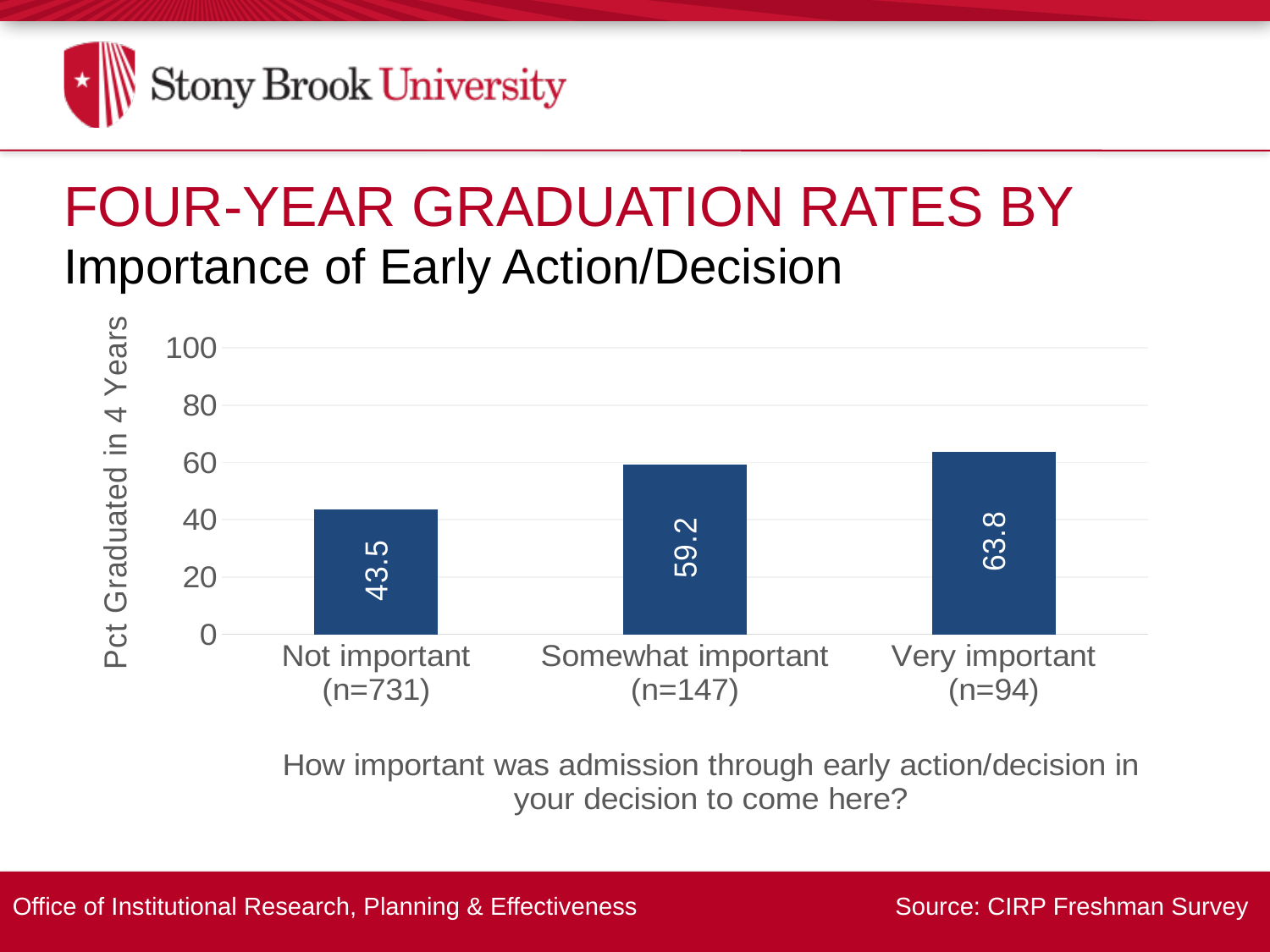
What is the four-year graduation rate for the Very important group? 63.8 Which group has a higher graduation rate, Somewhat important or Not important? Somewhat important What is the difference in graduation rate between the Somewhat important and Not important groups? 15.7 What is the difference in graduation rate between the Very important and Not important groups? 20.3 What type of chart is shown on the slide? bar chart Do the graduation rates rise or fall as importance increases from Not important to Very important? rise What is the four-year graduation rate for students who said early action/decision was Not important? 43.5 Is the graduation rate for the Not important group greater or less than 40? greater What is the four-year graduation rate for the Somewhat important group? 59.2 Which category has the highest four-year graduation rate? Very important Which category has the lowest four-year graduation rate? Not important How many categories are shown on the x axis? 3